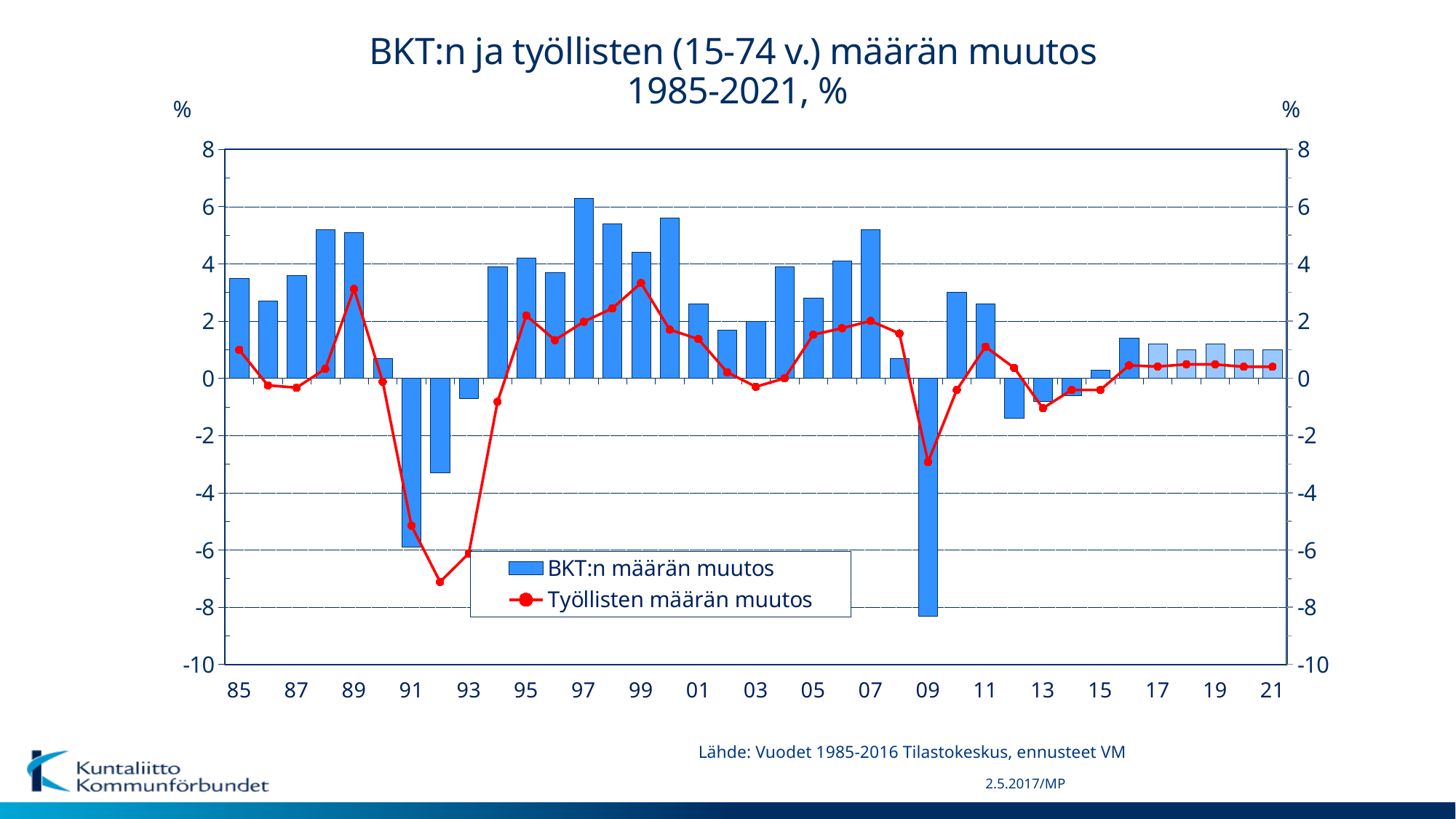
How many series does the legend list? 2 Is the BKT:n määrän muutos value for 1997 greater or less than 6? greater In which year is the BKT:n määrän muutos bar the lowest? 2009 Which year has a lower BKT:n määrän muutos value, 1991 or 2009? 2009 Which series is drawn as a red line with markers? Työllisten määrän muutos Is the BKT:n määrän muutos value for 2009 greater or less than -6? less How many years are plotted on the x axis from 1985 to 2021? 37 In which year is the BKT:n määrän muutos bar the highest? 1997 What kind of chart is shown on the slide? A combined bar and line chart In which year does the Työllisten määrän muutos line reach its lowest point? 1992 Is the Työllisten määrän muutos value for 1992 greater or less than -6? less What is the title of the chart? BKT:n ja työllisten (15-74 v.) määrän muutos 1985-2021, %